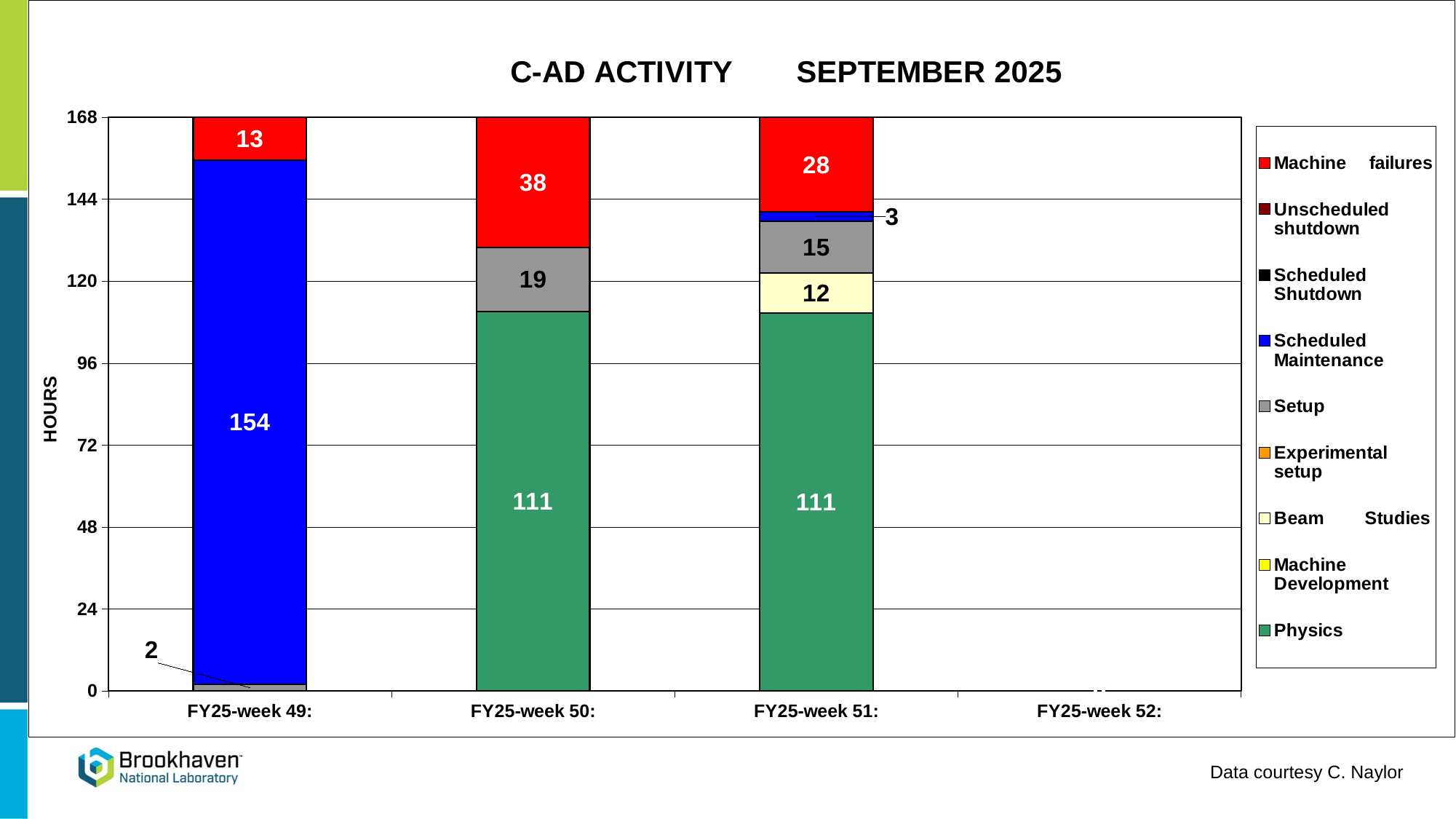
How many series does the legend list? 9 What is the Setup value for FY25-week 49? 2 Which week has the highest Machine failures value? FY25-week 50 How many Physics hours are shown for FY25-week 51? 111 Which week has the larger Setup value, FY25-week 50 or FY25-week 51? FY25-week 50 What is the Scheduled Maintenance value for FY25-week 49? 154 What is the total of the stacked bar for FY25-week 50? 168 How many hours of Machine failures are shown for FY25-week 50? 38 What kind of chart is shown on the slide? Stacked bar chart What is the Beam Studies value for FY25-week 51? 12 What is the difference between the Machine failures values for FY25-week 50 and FY25-week 51? 10 What is the Scheduled Maintenance value for FY25-week 51? 3